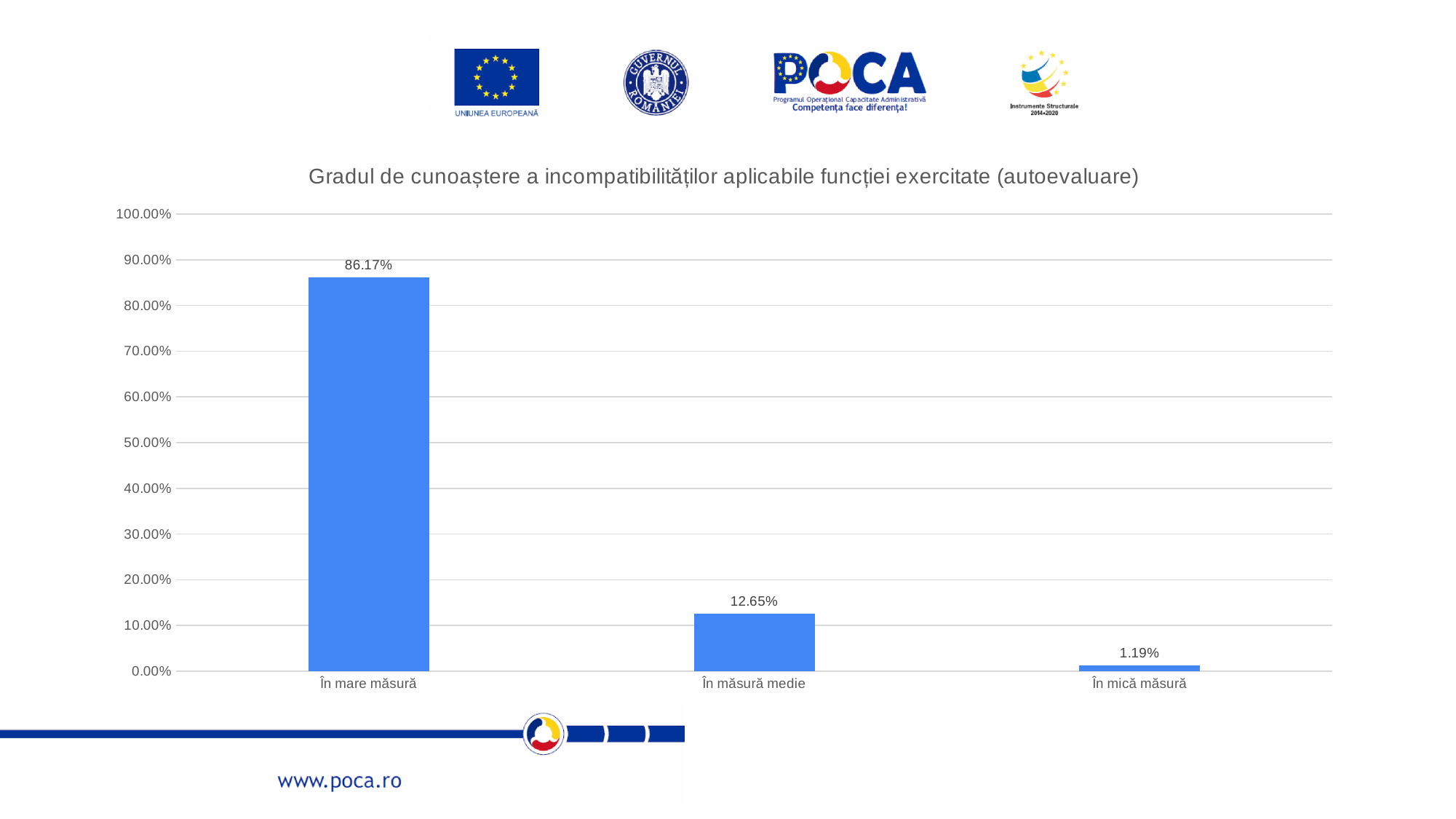
What is the value for 'În mică măsură'? 1.19% Which category has the lowest value? În mică măsură What kind of chart is shown on the slide? bar chart What is the difference between the values for 'În mare măsură' and 'În măsură medie'? 73.52% Is the value for 'În mare măsură' greater or less than 80.00%? greater Which is larger, the value for 'În măsură medie' or 'În mică măsură'? În măsură medie Which category has the highest value? În mare măsură What is the difference between the values for 'În măsură medie' and 'În mică măsură'? 11.46% How many categories are shown on the x axis? 3 What is the value for 'În măsură medie'? 12.65% What is the title of the chart? Gradul de cunoaștere a incompatibilităților aplicabile funcției exercitate (autoevaluare) What is the value for 'În mare măsură'? 86.17%